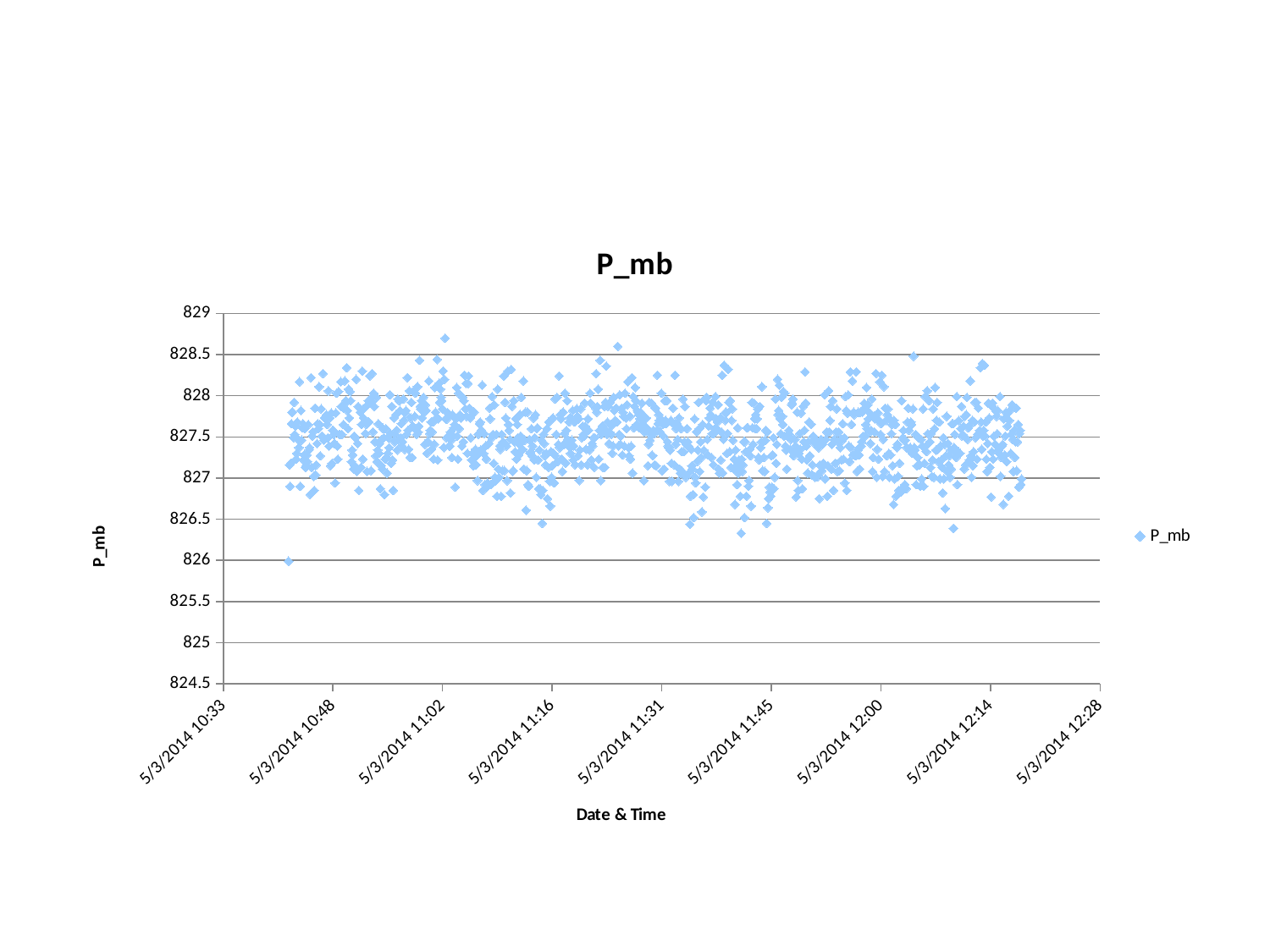
What is the label of the horizontal axis? Date & Time Do the plotted values show a clear rise, a clear fall, or stay roughly flat across the time axis? roughly flat What kind of chart is shown on the slide? scatter chart How many series does the legend list? 1 What is the title of the chart? P_mb Is the lowest plotted value on the chart greater or less than 826.5? less Are all of the plotted points greater or less than 829? less Are the majority of the plotted points greater or less than 826.5? greater